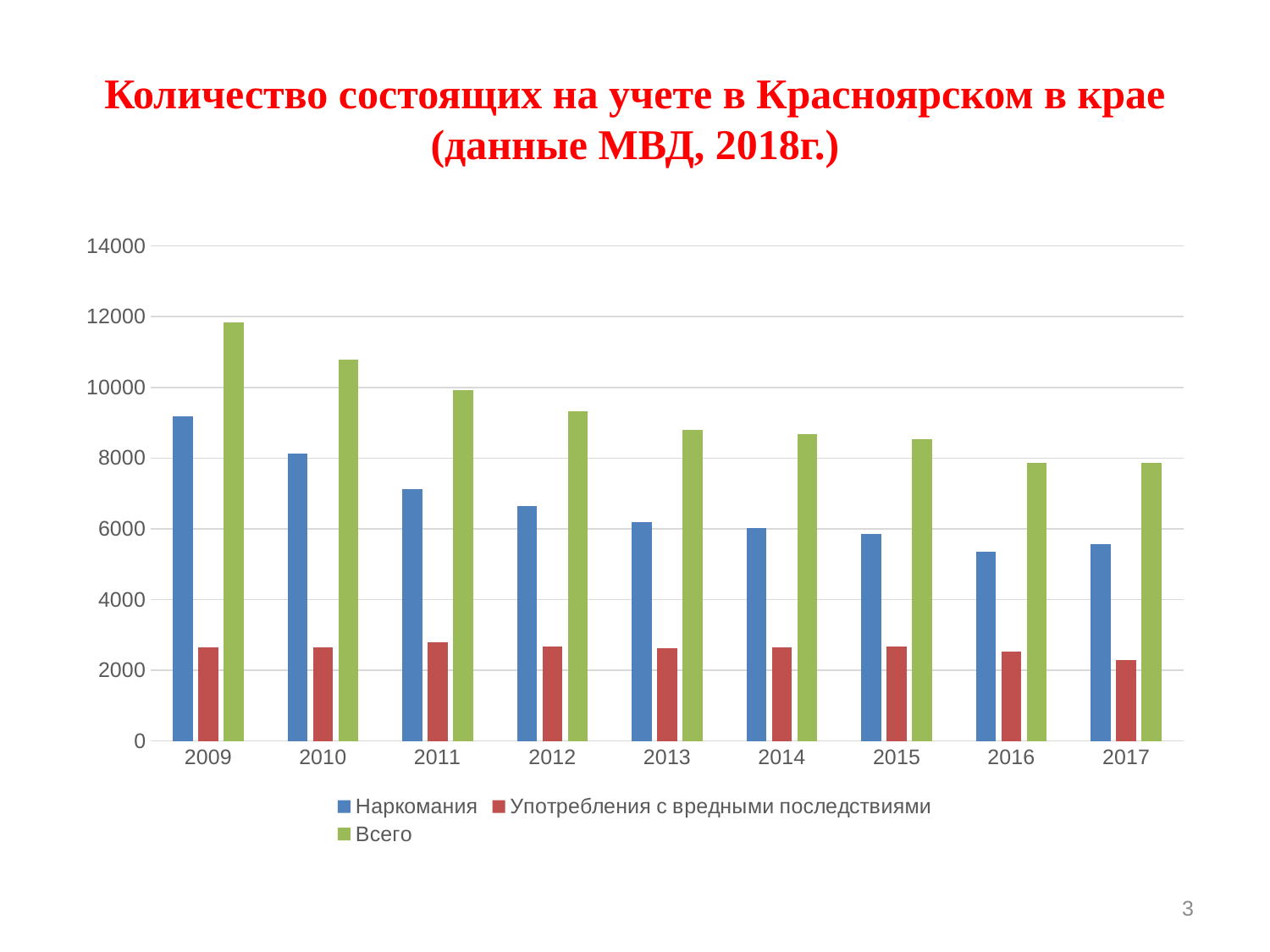
What kind of chart is shown on the slide? bar chart Is the value for Всего in 2012 greater or less than 10000? less In which year is the value for Всего the highest? 2009 In which year is the value for Наркомания the highest? 2009 How many series does the legend list? 3 Is the value for Употребления с вредными последствиями in 2011 greater or less than 2000? greater How many years are shown on the x axis? 9 Is the value for Всего in 2009 greater or less than 10000? greater Which is larger, the value for Всего in 2010 or in 2014? 2010 Do the values for Всего generally rise or fall from 2009 to 2017? fall